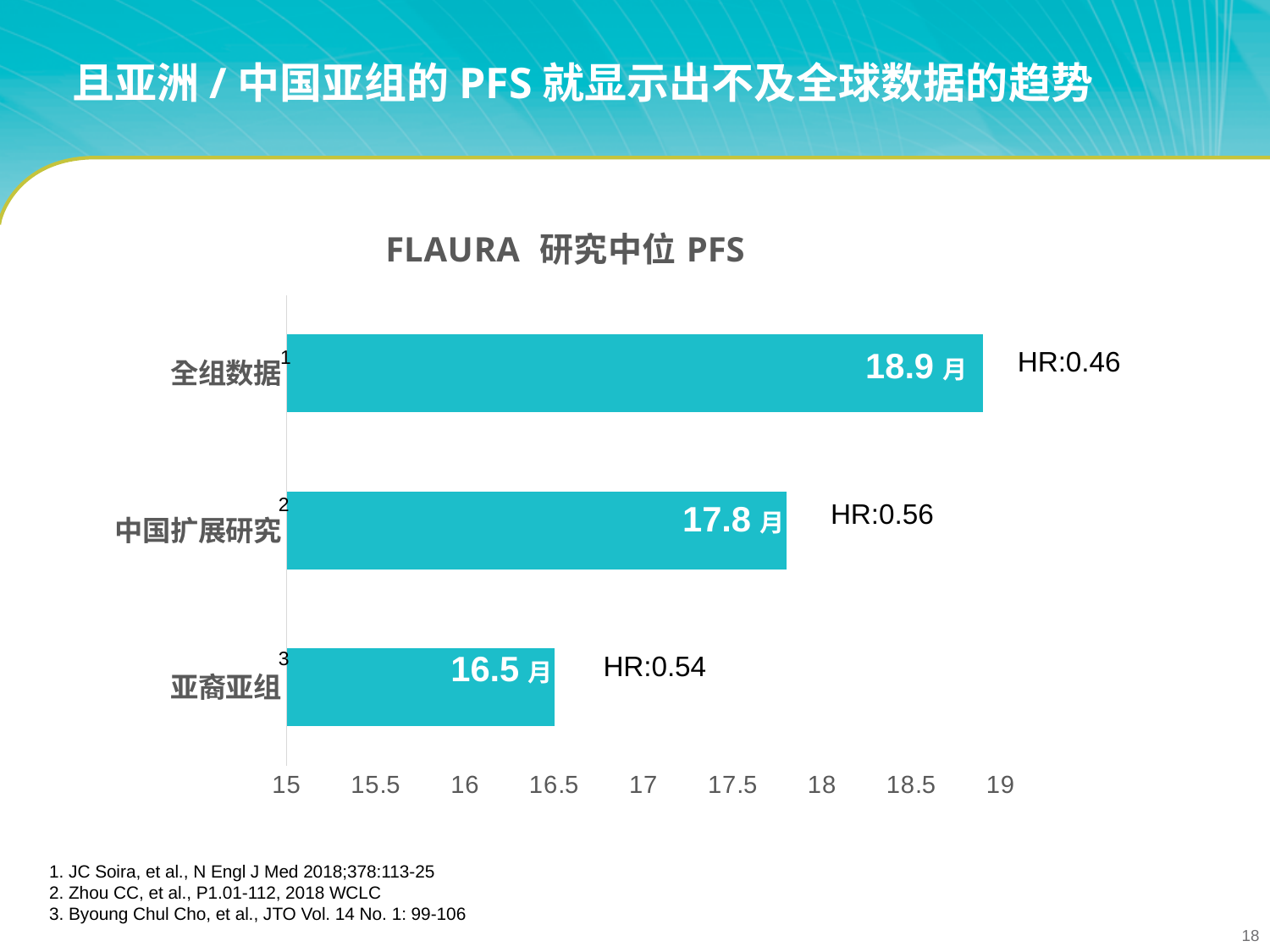
What is the median PFS value shown for 全组数据? 18.9 月 Is the value for 中国扩展研究 greater or less than 17? greater What is the difference in median PFS between 全组数据 and 中国扩展研究? 1.1 月 Which category has the lowest median PFS? 亚裔亚组 How many categories are shown in the chart? 3 What is the median PFS value shown for 中国扩展研究? 17.8 月 What is the difference in median PFS between 全组数据 and 亚裔亚组? 2.4 月 What kind of chart is shown on the slide? bar chart What is the title of the chart? FLAURA 研究中位 PFS What is the median PFS value shown for 亚裔亚组? 16.5 月 Which has a larger median PFS, 中国扩展研究 or 亚裔亚组? 中国扩展研究 Which category has the highest median PFS? 全组数据